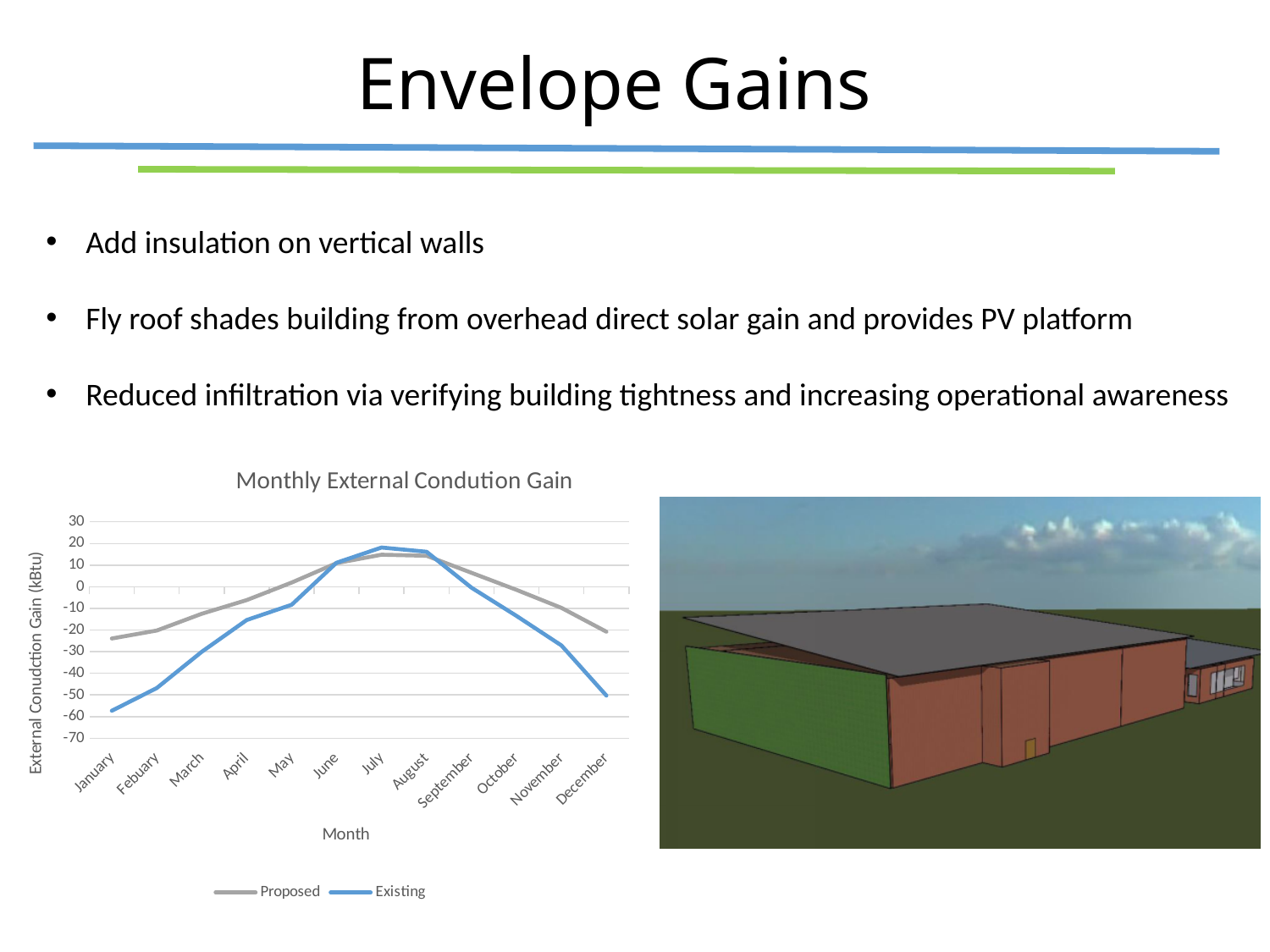
In the 'Monthly External Condution Gain' chart, in which month does the Existing series reach its lowest value? January In the 'Monthly External Condution Gain' chart, which series has the higher value in January, Proposed or Existing? Proposed What kind of chart is the 'Monthly External Condution Gain' chart? line chart What are the two legend entries in the 'Monthly External Condution Gain' chart? Proposed and Existing In the 'Monthly External Condution Gain' chart, is the Existing value for December greater or less than -40? less What is the x-axis title of the 'Monthly External Condution Gain' chart? Month How many series does the legend of the 'Monthly External Condution Gain' chart list? 2 In the 'Monthly External Condution Gain' chart, is the Proposed value for January greater or less than -30? greater In the 'Monthly External Condution Gain' chart, which series has the higher value in July, Proposed or Existing? Existing In the 'Monthly External Condution Gain' chart, is the Existing value for January greater or less than -50? less How many months are plotted along the x axis of the 'Monthly External Condution Gain' chart? 12 In the 'Monthly External Condution Gain' chart, does the Existing series rise or fall from January to July? rise